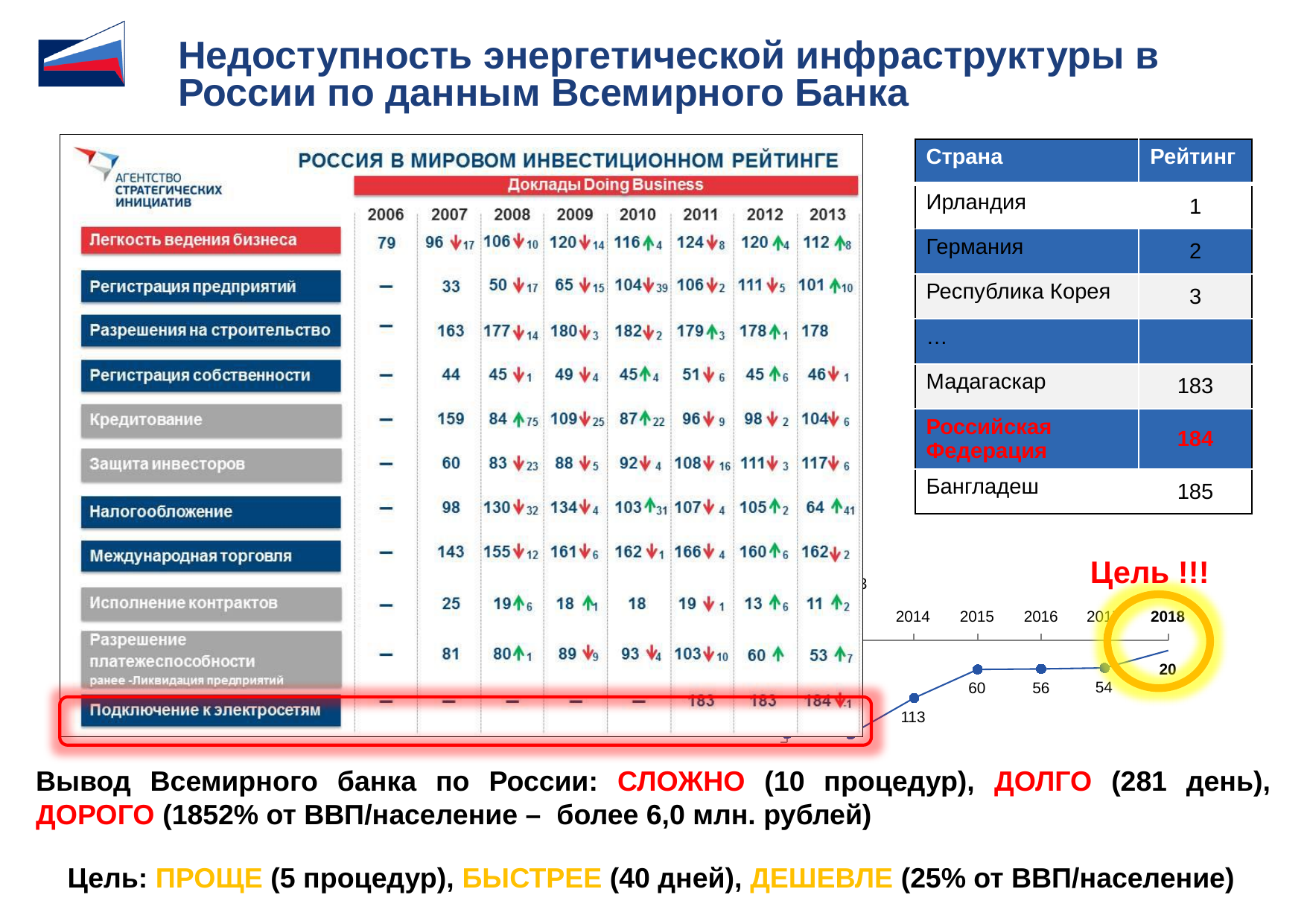
In the line chart in the lower right, what is the value plotted for 2015? 60 In the line chart in the lower right, what is the value plotted for 2018? 20 In the line chart in the lower right, what is the value plotted for 2014? 113 In the line chart in the lower right, do the values rise or fall from 2014 to 2018? fall What kind of chart is shown in the lower right of the slide, below the country rating table? line chart In the line chart in the lower right, what is the value plotted for 2016? 56 In the line chart in the lower right, which of the labelled years has the lowest value? 2018 In the line chart in the lower right, what is the difference between the 2015 value and the 2016 value? 4 In the line chart in the lower right, what is the difference between the 2014 value and the 2015 value? 53 In the line chart in the lower right, which year has the larger value, 2014 or 2018? 2014 In the line chart in the lower right, which year is circled and marked with the annotation 'Цель !!!'? 2018